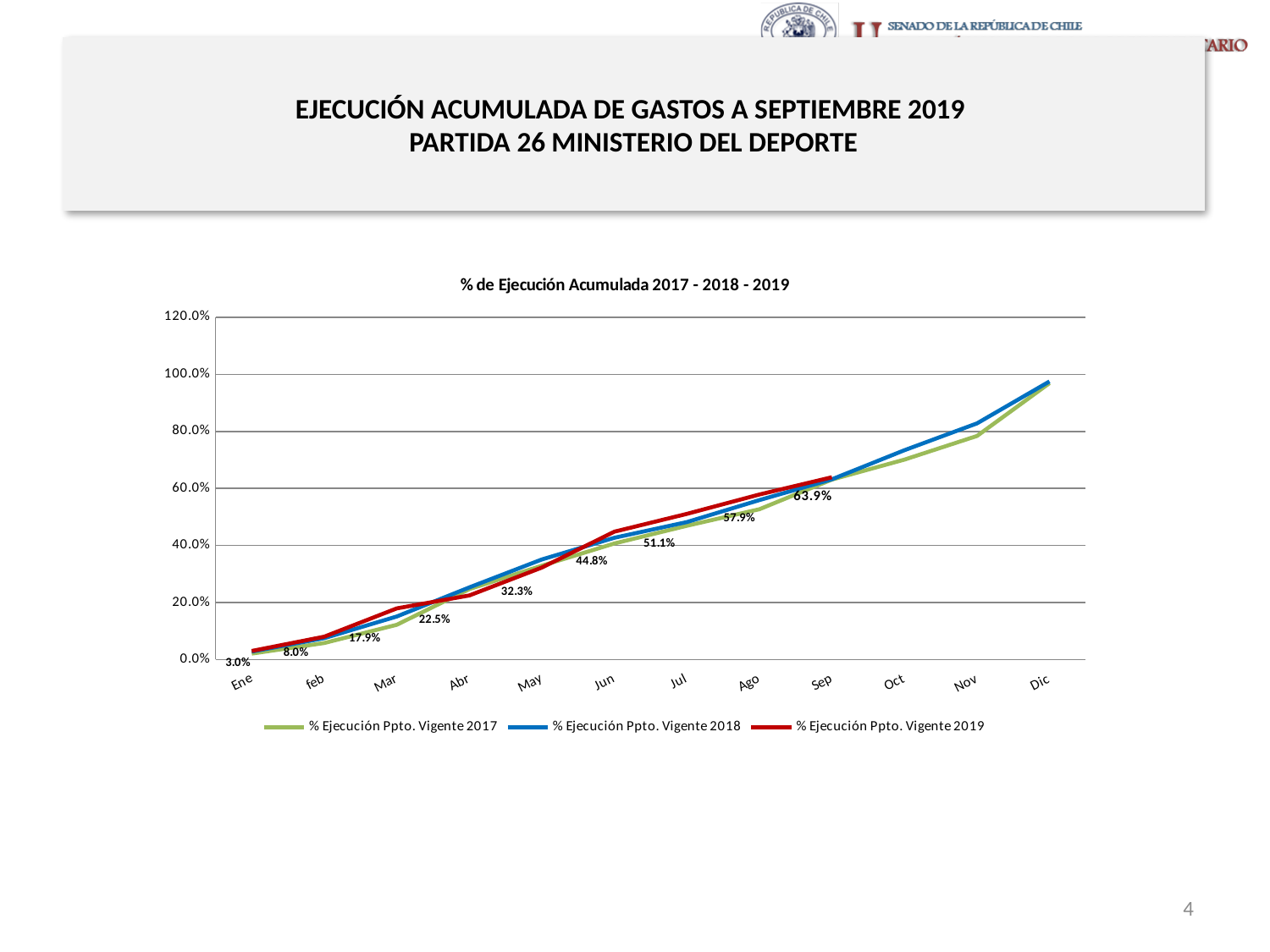
How many months are shown on the x axis? 12 What is the difference between the 2019 values for Sep and Ago? 6.0% What is the title of the chart? % de Ejecución Acumulada 2017 - 2018 - 2019 What is the value of % Ejecución Ppto. Vigente 2019 in Jun? 44.8% What kind of chart is shown on the slide? line chart How many series does the legend list? 3 What is the value of % Ejecución Ppto. Vigente 2019 in May? 32.3% Which month has the highest value for % Ejecución Ppto. Vigente 2019? Sep What is the value of % Ejecución Ppto. Vigente 2019 in Ene? 3.0% Does the % Ejecución Ppto. Vigente 2019 series rise or fall from Ene to Sep? rise Is the value for % Ejecución Ppto. Vigente 2018 in Dic greater or less than 80.0%? greater What is the value of % Ejecución Ppto. Vigente 2019 in Sep? 63.9%